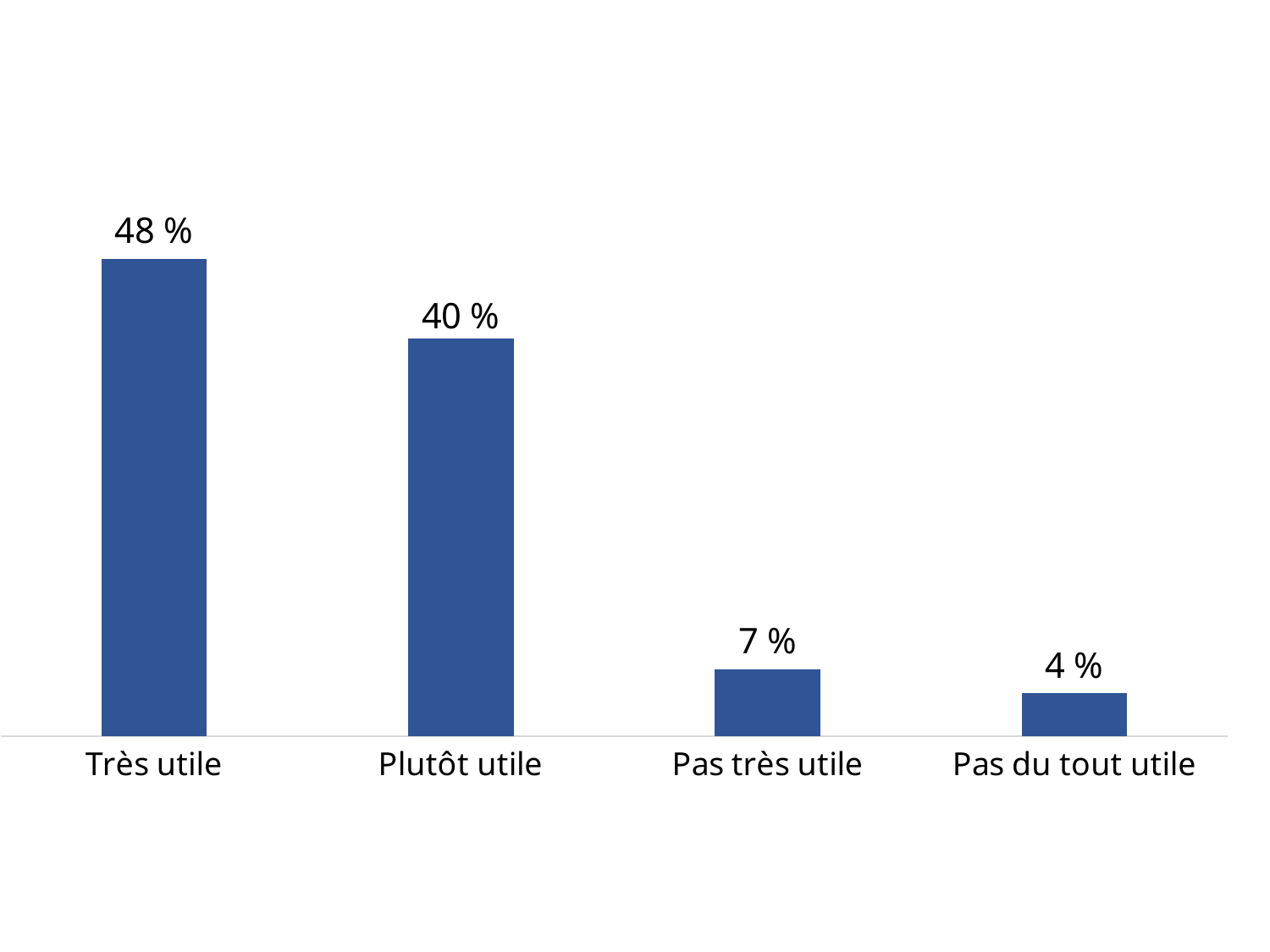
Which category has the highest value? Très utile Do the values rise or fall from left to right along the x axis? Fall What is the difference between the values for "Pas très utile" and "Pas du tout utile"? 3 % Which is larger, the value for "Plutôt utile" or the value for "Pas très utile"? Plutôt utile What is the difference between the values for "Très utile" and "Plutôt utile"? 8 % Which category has the lowest value? Pas du tout utile What is the value for "Très utile"? 48 % What is the value for "Plutôt utile"? 40 % What is the value for "Pas du tout utile"? 4 % What kind of chart is shown on the slide? Bar chart What is the value for "Pas très utile"? 7 % How many categories are shown on the chart? 4